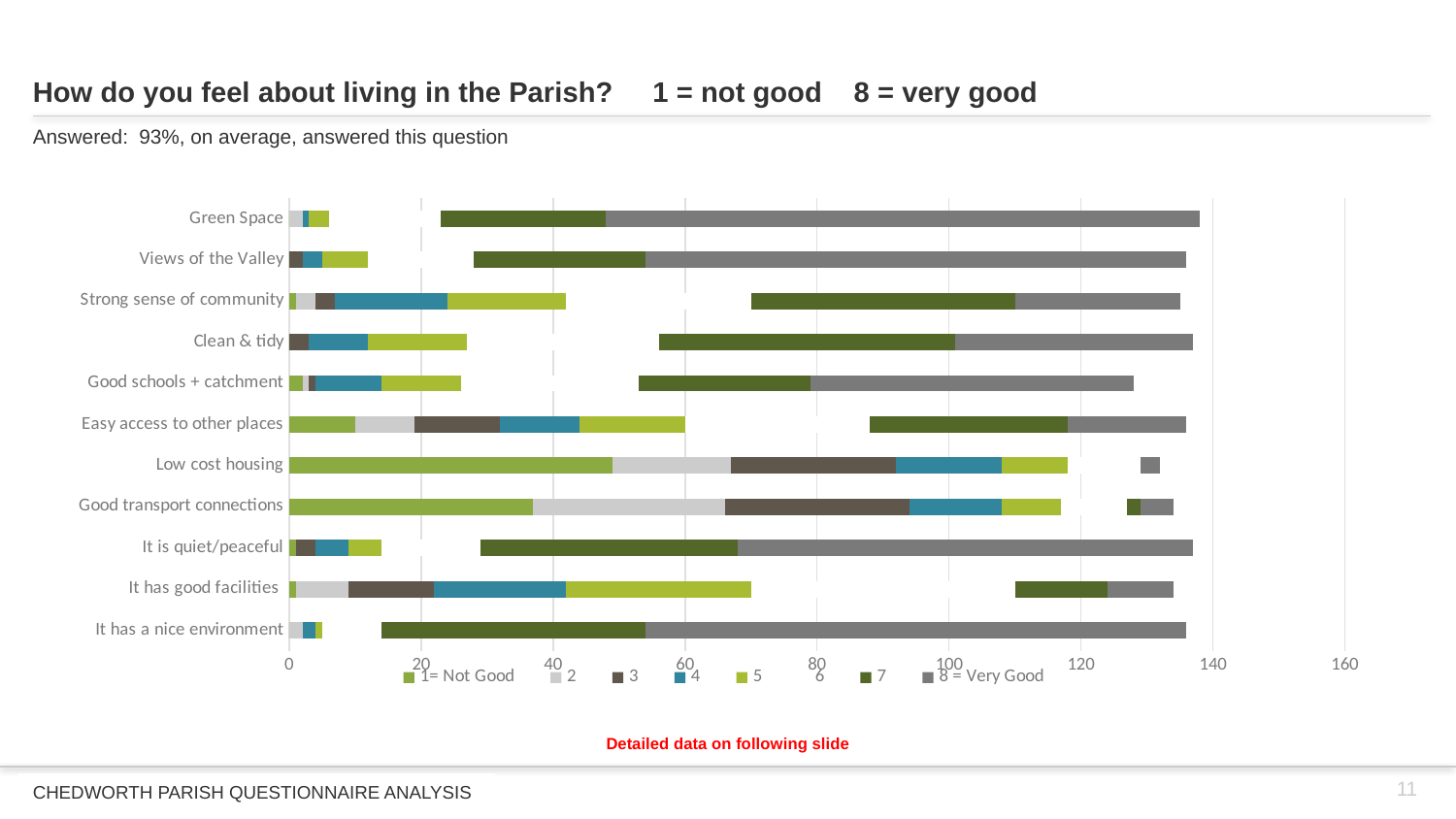
How many categories (aspects of living in the Parish) are listed on the vertical axis of the chart? 11 How many series does the chart's legend list? 8 Is the '1= Not Good' segment larger for Low cost housing or for Good transport connections? Low cost housing Which category has the longest '1= Not Good' segment? Low cost housing What is the label of the last series in the chart's legend? 8 = Very Good Is the '1= Not Good' segment for Good transport connections greater or less than 20? greater What kind of chart is shown on the slide? Stacked bar chart What is the label of the first series in the chart's legend? 1= Not Good What is the highest value shown on the horizontal axis of the chart? 160 Is the total length of the stacked bar for Green Space greater or less than 120? greater Is the '1= Not Good' segment for Low cost housing greater or less than 40? greater